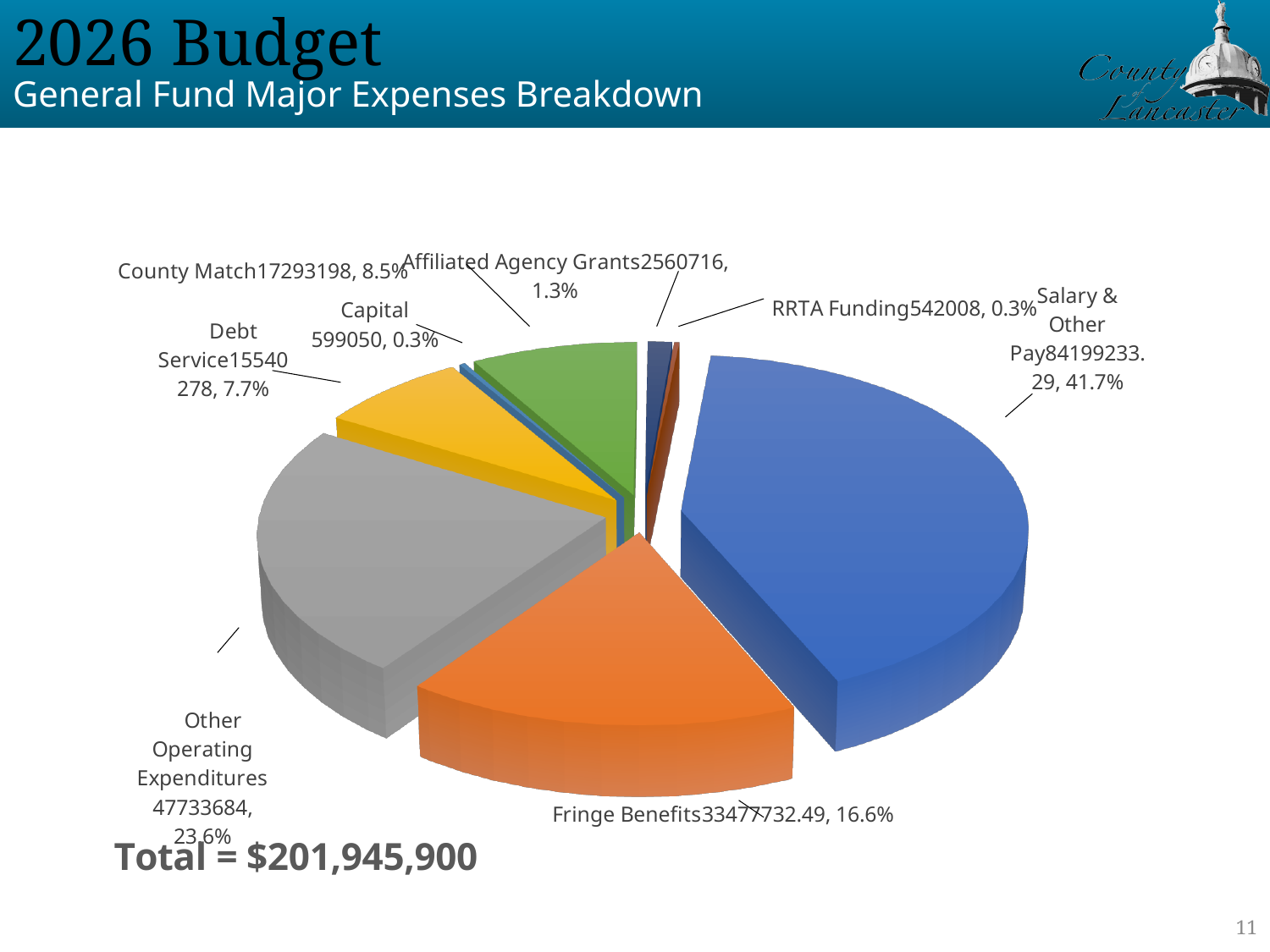
Which is larger: the share for Other Operating Expenditures or the share for Fringe Benefits? Other Operating Expenditures What percentage of the pie does Fringe Benefits represent? 16.6% What is the difference in percentage points between the Salary & Other Pay share and the Fringe Benefits share? 25.1 percentage points What is the value shown for County Match? 17293198 What percentage share is shown for Debt Service? 7.7% What is the value shown for Other Operating Expenditures? 47733684 Which category has the largest share of the pie? Salary & Other Pay What type of chart is shown on the slide? Pie chart How many categories are shown in the pie chart? 8 What percentage of the General Fund major expenses is Salary & Other Pay? 41.7% What total is stated on the slide for the General Fund major expenses? $201,945,900 Which category has the smallest value shown on the chart? RRTA Funding